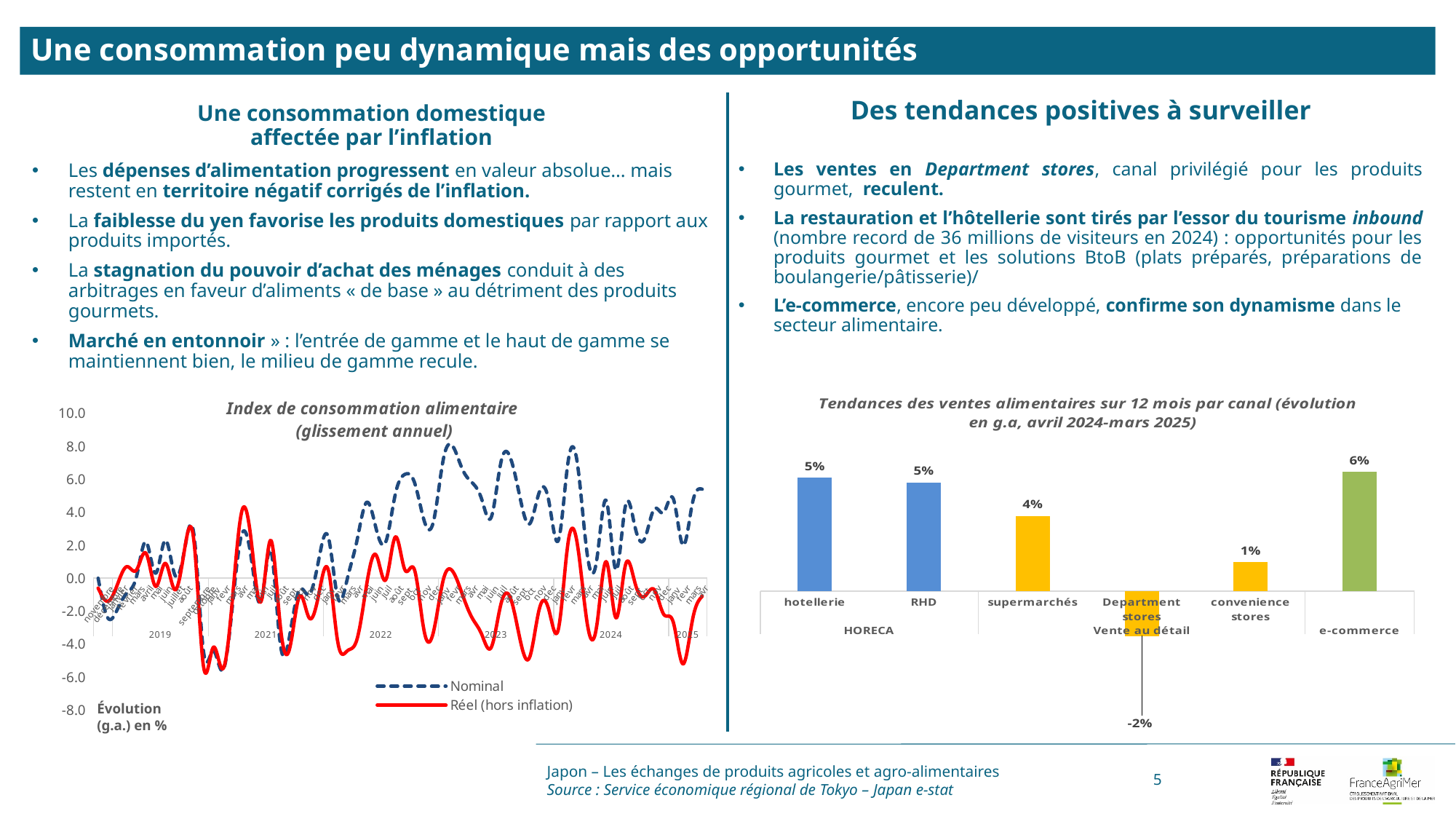
How many channels (bars) are shown in the chart 'Tendances des ventes alimentaires sur 12 mois par canal'? 6 In the chart 'Tendances des ventes alimentaires sur 12 mois par canal', what is the value for e-commerce? 6% In the chart 'Tendances des ventes alimentaires sur 12 mois par canal', which channel has the lowest value? Department stores What kind of chart is 'Tendances des ventes alimentaires sur 12 mois par canal'? Bar chart What kind of chart is 'Index de consommation alimentaire (glissement annuel)'? Line chart In the chart 'Tendances des ventes alimentaires sur 12 mois par canal', what is the value for supermarchés? 4% How many series does the legend of the chart 'Index de consommation alimentaire (glissement annuel)' list? 2 In the chart 'Index de consommation alimentaire (glissement annuel)', which series is drawn as a dashed line? Nominal In the chart 'Tendances des ventes alimentaires sur 12 mois par canal', which channel has the highest value? e-commerce In the chart 'Tendances des ventes alimentaires sur 12 mois par canal', which is larger: the value for supermarchés or the value for convenience stores? supermarchés In the chart 'Tendances des ventes alimentaires sur 12 mois par canal', what is the value for Department stores? -2% In the chart 'Tendances des ventes alimentaires sur 12 mois par canal', what is the difference between the values for e-commerce and convenience stores? 5 percentage points